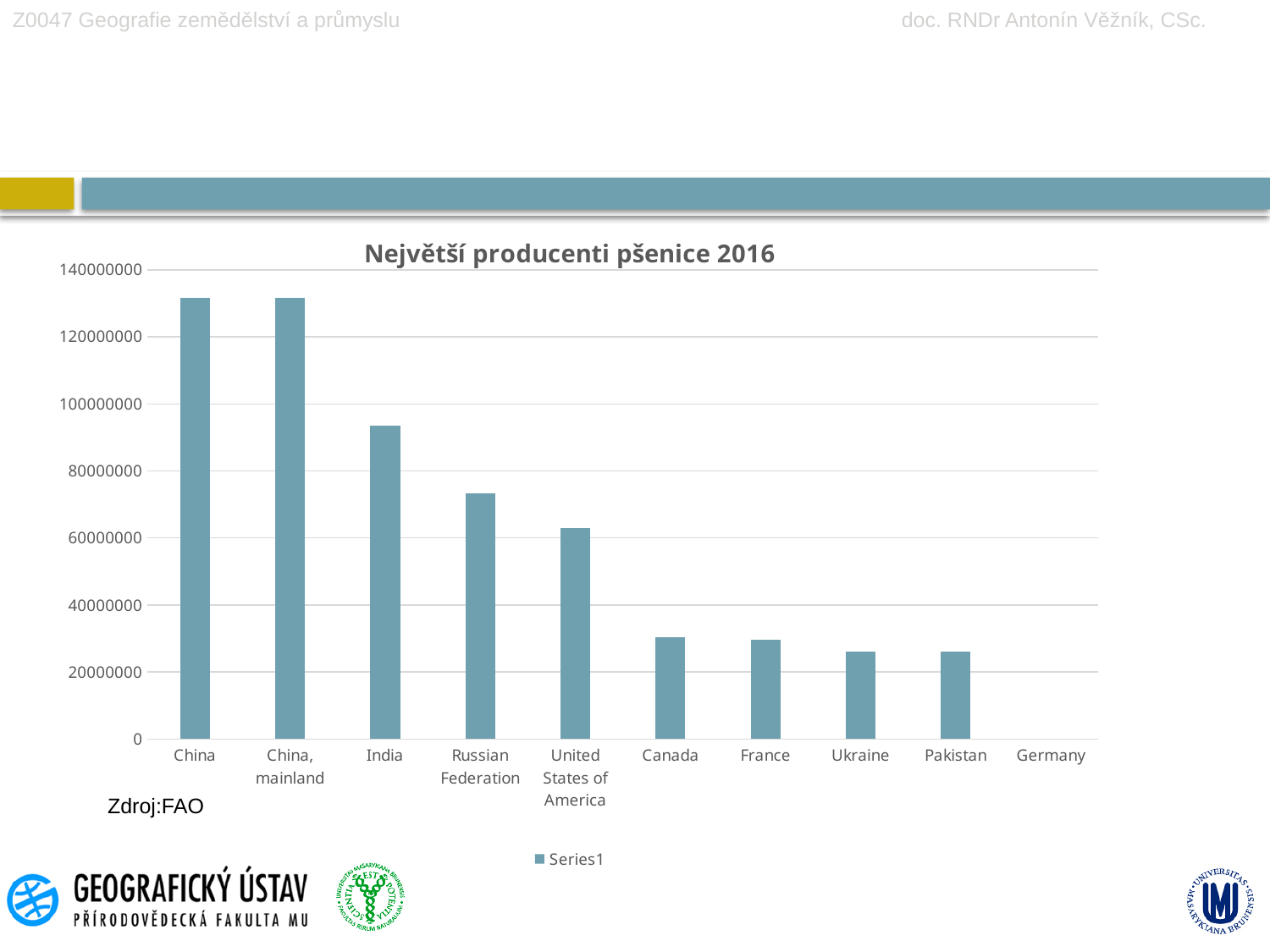
Is the value for Canada greater or less than 40000000? less Which has a larger value, United States of America or Canada? United States of America Which has a larger value, India or Russian Federation? India What kind of chart is shown on the slide? bar chart What is the title of the chart? Největší producenti pšenice 2016 How many series does the legend list? 1 Do the values generally rise or fall from left to right along the x axis? fall Is the value for Russian Federation greater or less than 80000000? less Is the value for Ukraine greater or less than 20000000? greater How many categories are shown on the x axis of the chart? 10